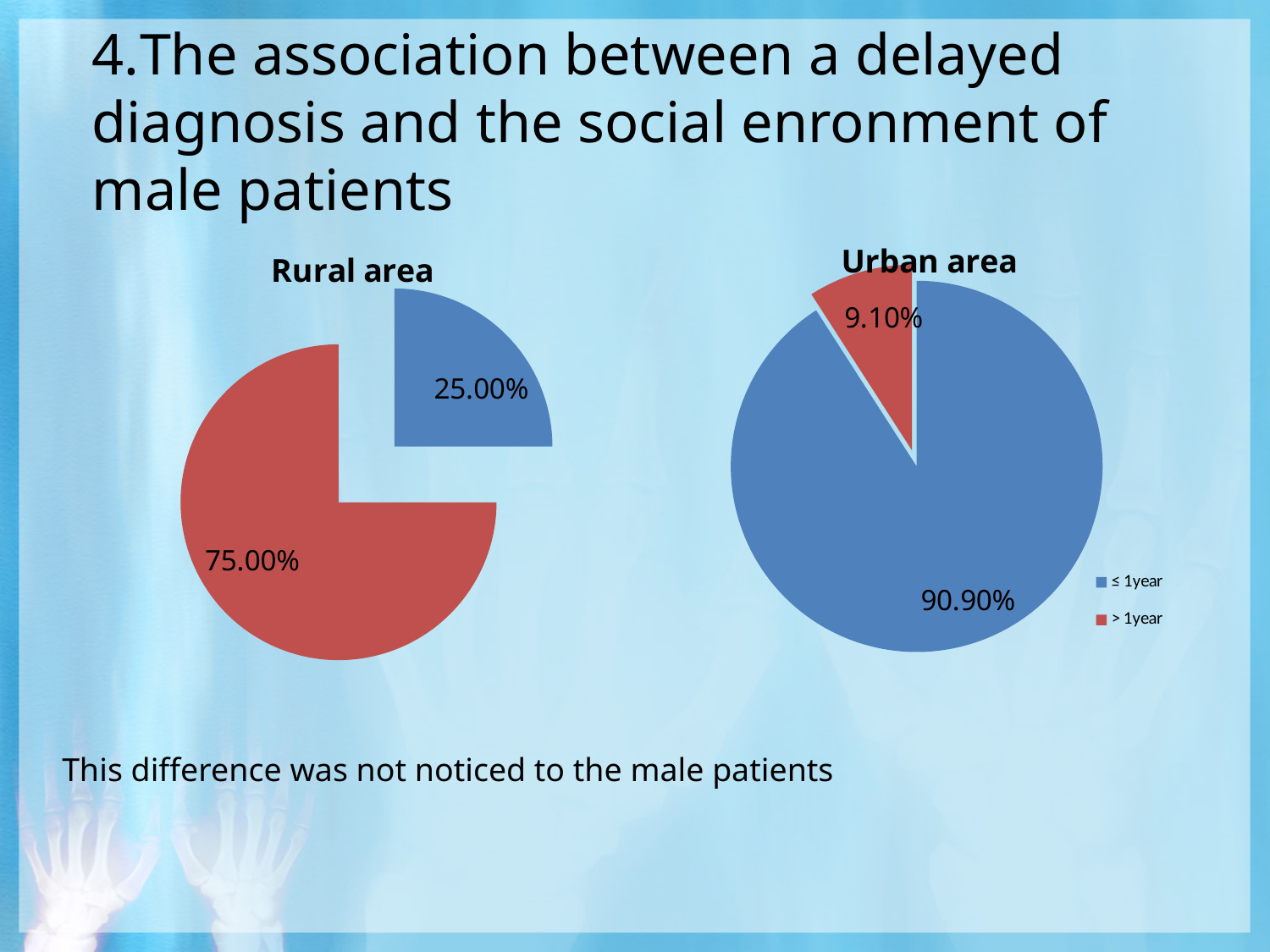
What type of chart is used for the Rural area and Urban area data? Pie chart In the Urban area chart, which category has the smallest slice? > 1year In the Rural area chart, which category has the largest slice? > 1year In the Rural area chart, what share of male patients had a diagnosis delay of ≤ 1year? 25.00% How many slices does the Urban area chart have? 2 Which colour represents the ≤ 1year category in the legend? Blue In the Urban area chart, what share of male patients had a diagnosis delay of ≤ 1year? 90.90% In the Urban area chart, what is the difference in percentage points between the ≤ 1year and > 1year slices? 81.80% In the Urban area chart, what share of male patients had a diagnosis delay of > 1year? 9.10% Which chart has the larger share for > 1year, Rural area or Urban area? Rural area In the Rural area chart, what share of male patients had a diagnosis delay of > 1year? 75.00% In the Rural area chart, what is the difference in percentage points between the > 1year and ≤ 1year slices? 50.00%